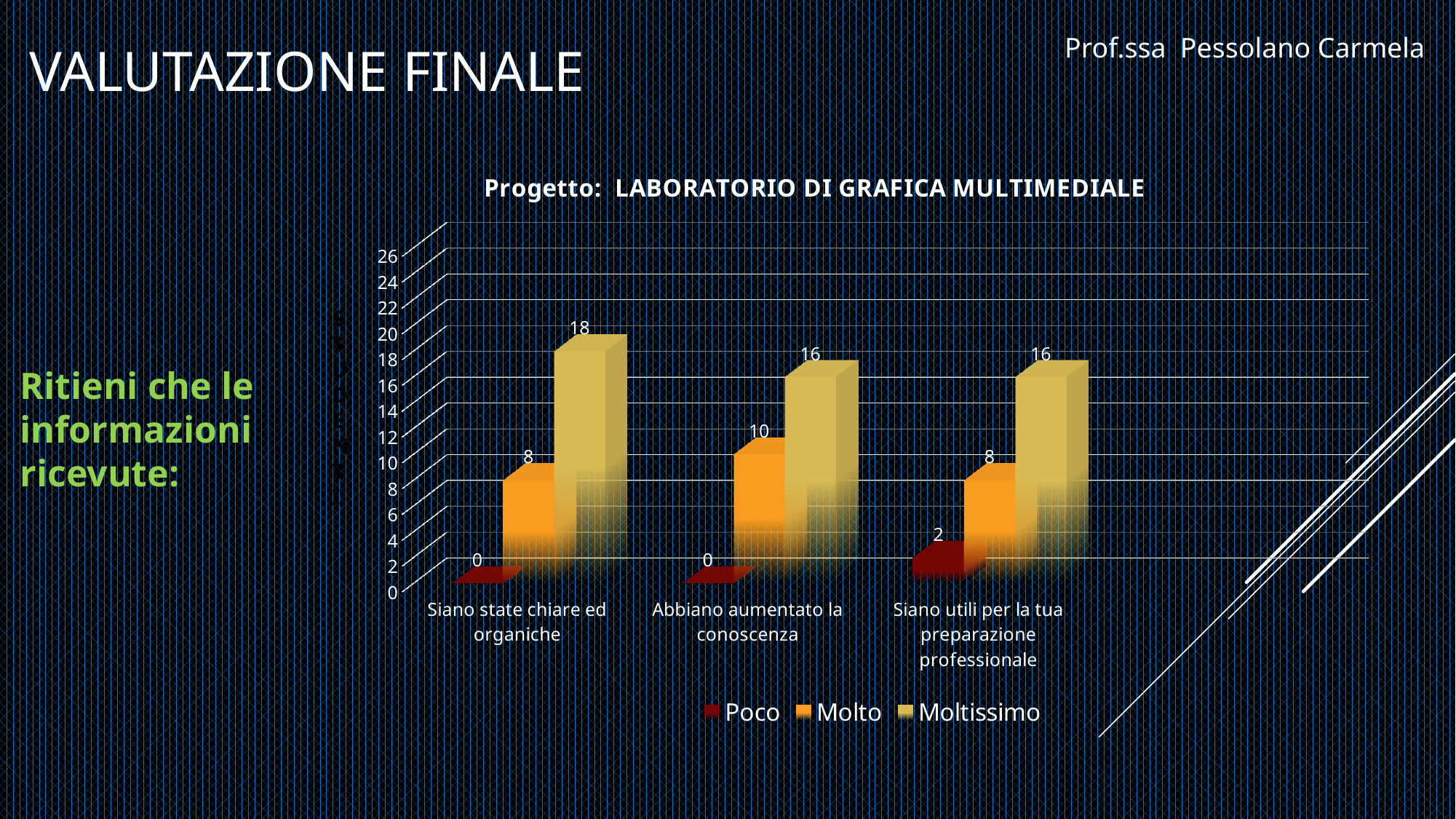
What is the title of the chart? Progetto: LABORATORIO DI GRAFICA MULTIMEDIALE What is the value for Moltissimo in the category 'Siano state chiare ed organiche'? 18 What is the difference between the Moltissimo and Molto values in the category 'Siano state chiare ed organiche'? 10 What is the value for Molto in the category 'Abbiano aumentato la conoscenza'? 10 What is the value for Poco in the category 'Siano utili per la tua preparazione professionale'? 2 How many categories are shown on the x axis? 3 Which category has the highest Molto value? Abbiano aumentato la conoscenza What kind of chart is shown on the slide? Bar chart What is the value for Poco in the category 'Siano state chiare ed organiche'? 0 Which category has the highest Moltissimo value? Siano state chiare ed organiche In the category 'Siano utili per la tua preparazione professionale', which is larger: Molto or Moltissimo? Moltissimo How many series does the legend list? 3